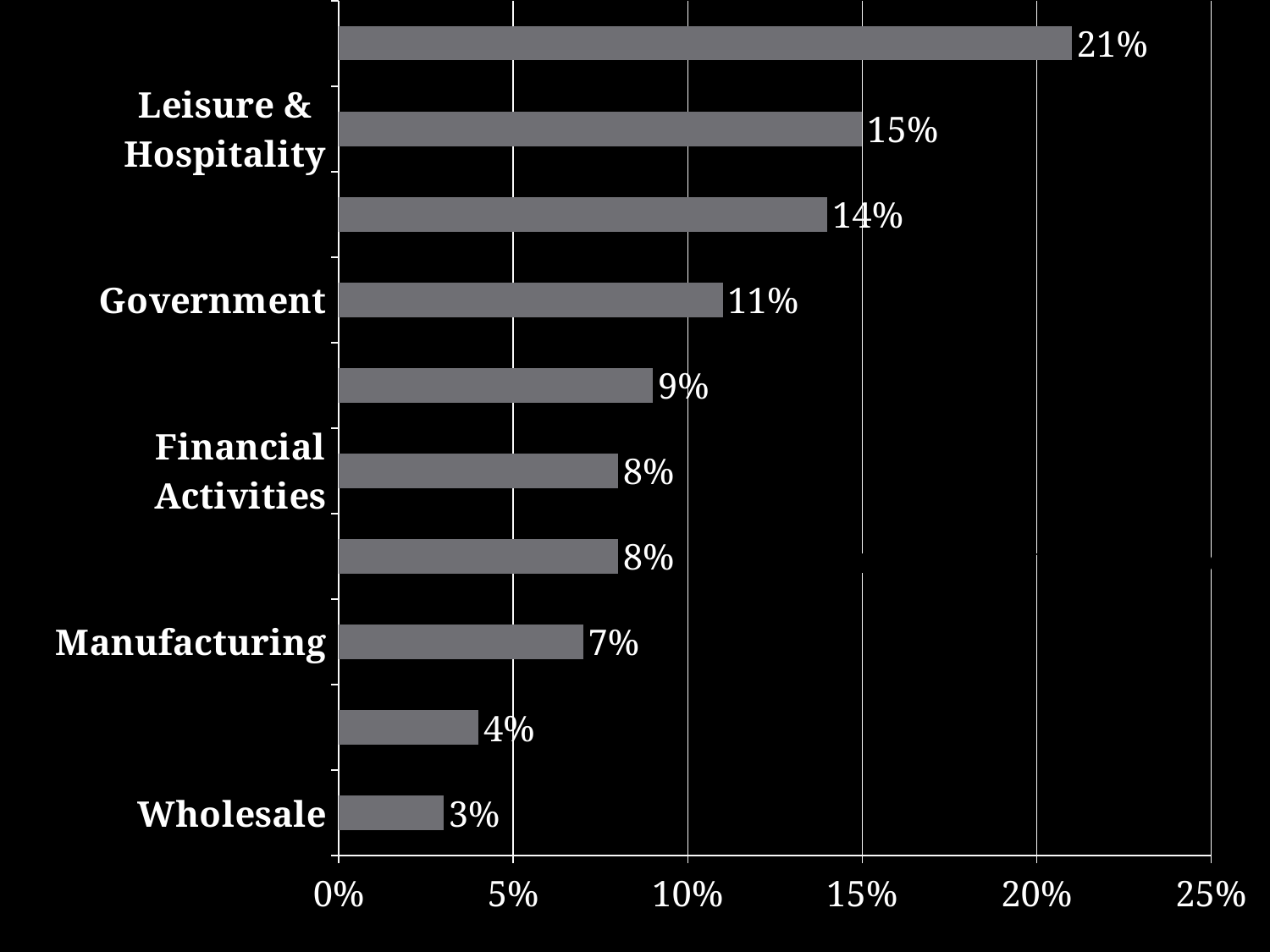
Which labelled category has the lowest value? Wholesale What is the difference between the values for Manufacturing and Wholesale? 4% What is the value for Manufacturing? 7% What is the value for Leisure & Hospitality? 15% What is the value for Government? 11% What is the value for Wholesale? 3% What is the difference between the values for Leisure & Hospitality and Government? 4% What kind of chart is shown on the slide? Bar chart Which is larger, the value for Government or the value for Financial Activities? Government Is the value for Leisure & Hospitality greater or less than 10%? greater How many bars are plotted on the chart? 10 What is the value for Financial Activities? 8%